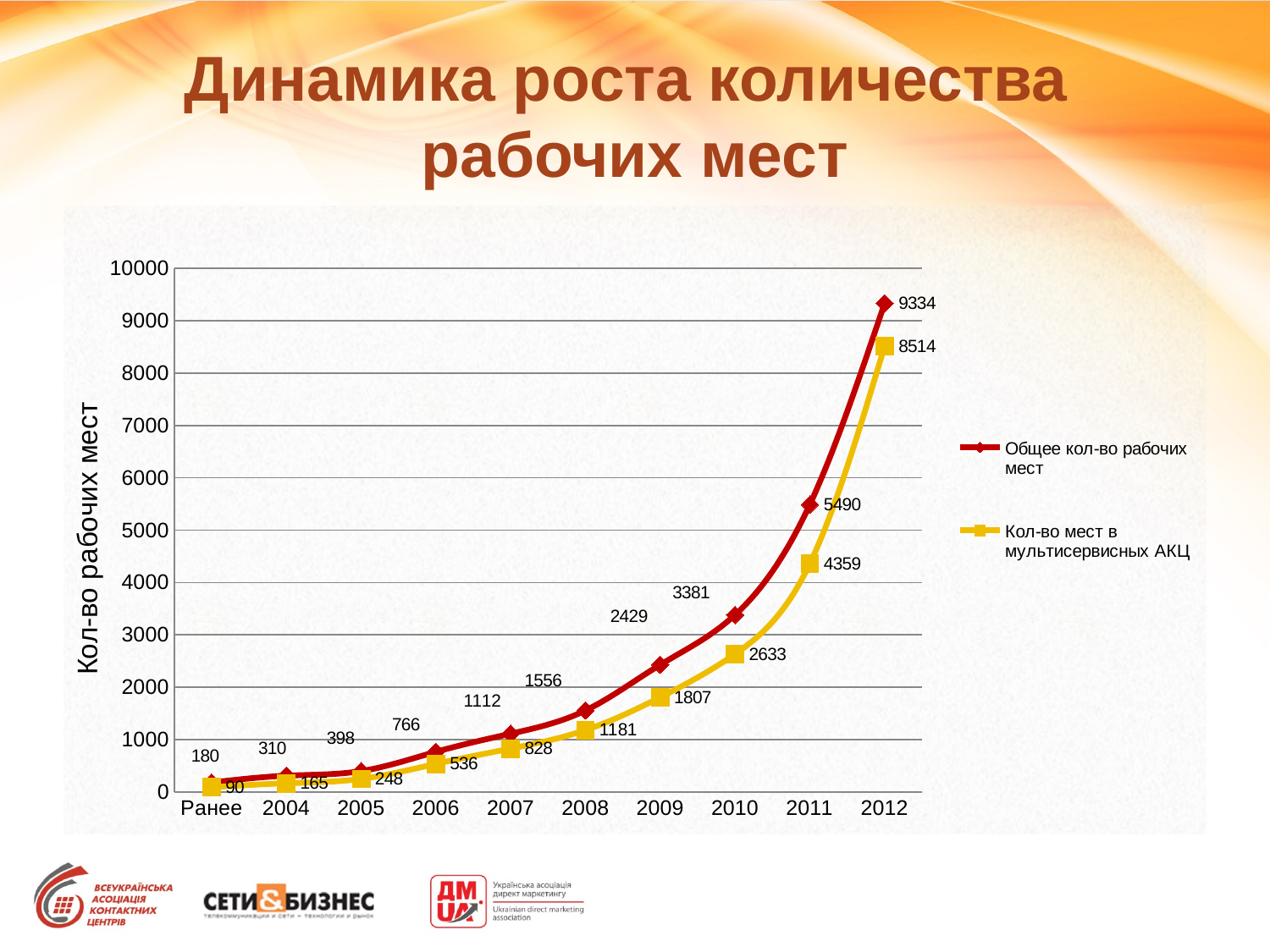
How many points are plotted along the x axis for each series? 10 What is the difference between "Общее кол-во рабочих мест" and "Кол-во мест в мультисервисных АКЦ" in 2012? 820 Which is larger in 2010: "Общее кол-во рабочих мест" or "Кол-во мест в мультисервисных АКЦ"? Общее кол-во рабочих мест What type of chart is shown on the slide? Line chart What is the value of "Кол-во мест в мультисервисных АКЦ" in 2011? 4359 What is the value of "Общее кол-во рабочих мест" in 2008? 1556 Which category has the lowest value for "Кол-во мест в мультисервисных АКЦ"? Ранее What is the value of "Общее кол-во рабочих мест" in 2012? 9334 How many series does the legend list? 2 Do the values of "Общее кол-во рабочих мест" rise or fall from "Ранее" to 2012? Rise In which year does "Общее кол-во рабочих мест" reach its highest value? 2012 What is the value of "Кол-во мест в мультисервисных АКЦ" for "Ранее"? 90